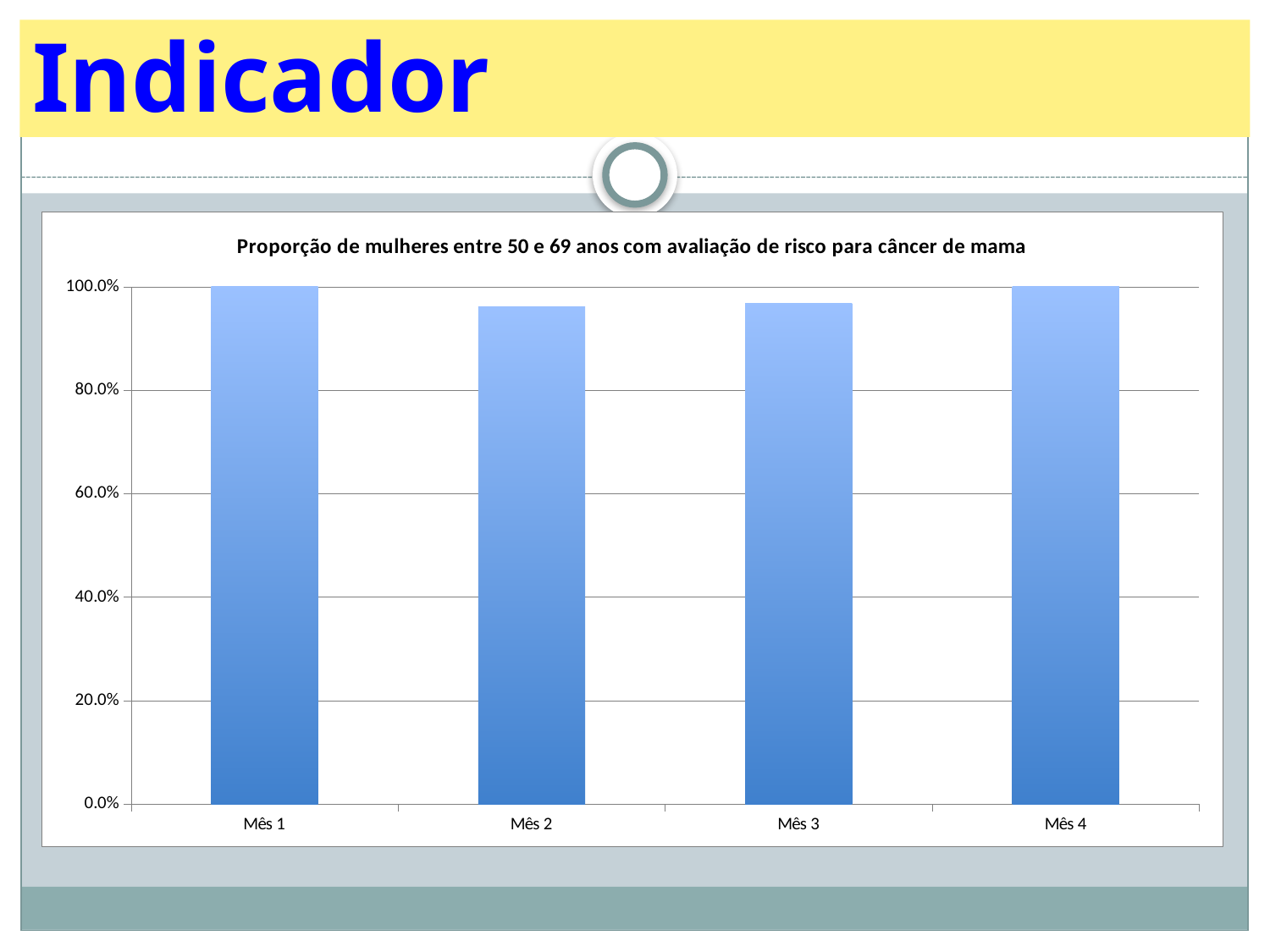
What is the value for Mês 1? 100.0% What is the value for Mês 4? 100.0% Which is larger, the value for Mês 1 or the value for Mês 2? Mês 1 How many categories (months) are shown on the x axis? 4 What type of chart is shown on the slide? bar chart Is the value for Mês 2 greater or less than 80.0%? greater What is the title of the chart? Proporção de mulheres entre 50 e 69 anos com avaliação de risco para câncer de mama Which is larger, the value for Mês 4 or the value for Mês 3? Mês 4 Is the value for Mês 2 greater or less than 60.0%? greater What is the label of the first category on the x axis? Mês 1 Is the value for Mês 3 greater or less than 100.0%? less